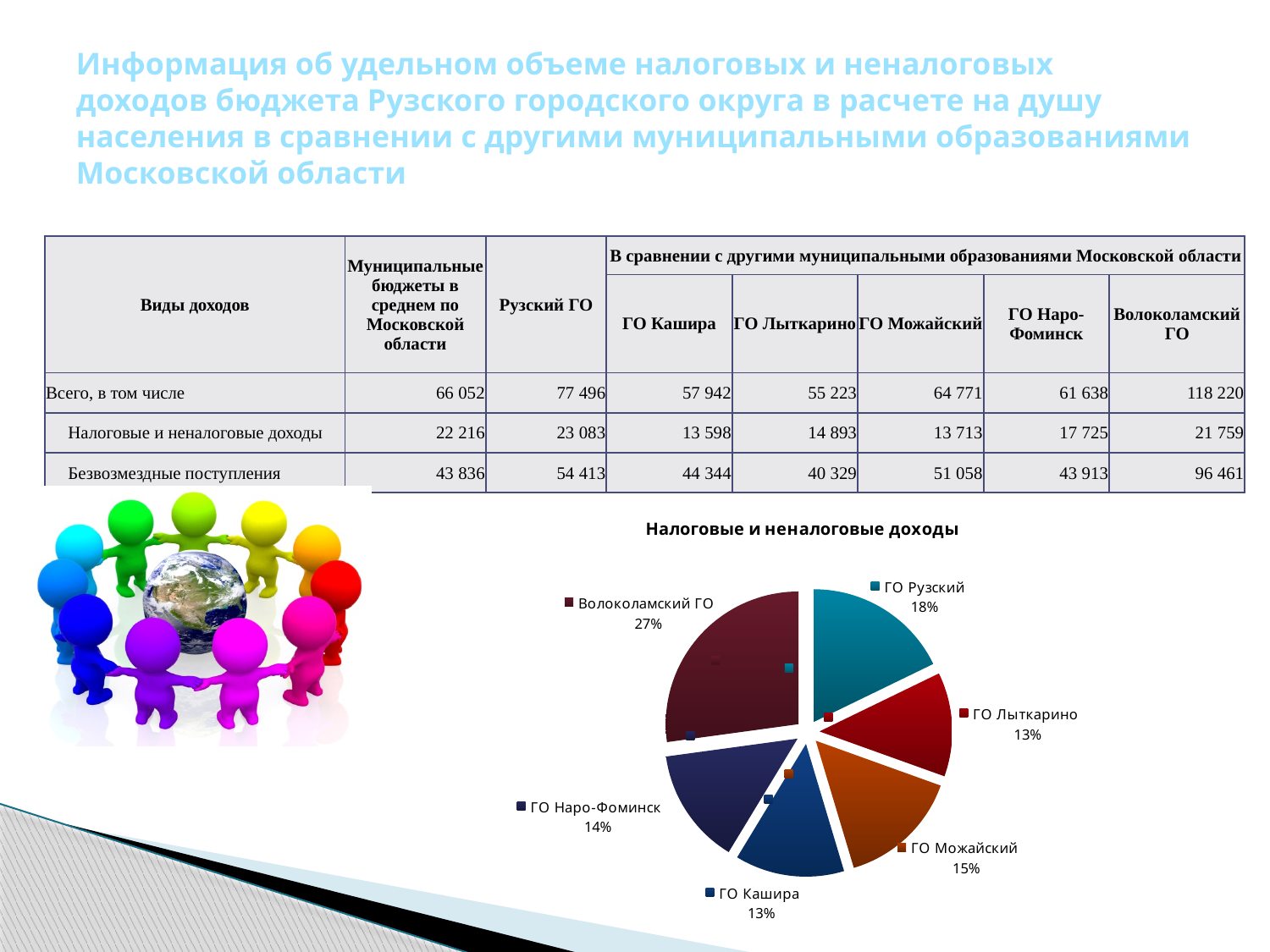
What is the title of the pie chart? Налоговые и неналоговые доходы What share of the pie does ГО Рузский have? 18% What share of the pie does Волоколамский ГО have? 27% What share of the pie does ГО Наро-Фоминск have? 14% Which two slices in the pie chart both have a share of 13%? ГО Лыткарино and ГО Кашира How many slices does the pie chart have? 6 What kind of chart is shown on the slide? pie chart Which has a larger share in the pie chart, ГО Рузский or ГО Можайский? ГО Рузский Which slice of the pie chart is the largest? Волоколамский ГО What is the difference in percentage points between the shares of Волоколамский ГО and ГО Рузский? 9